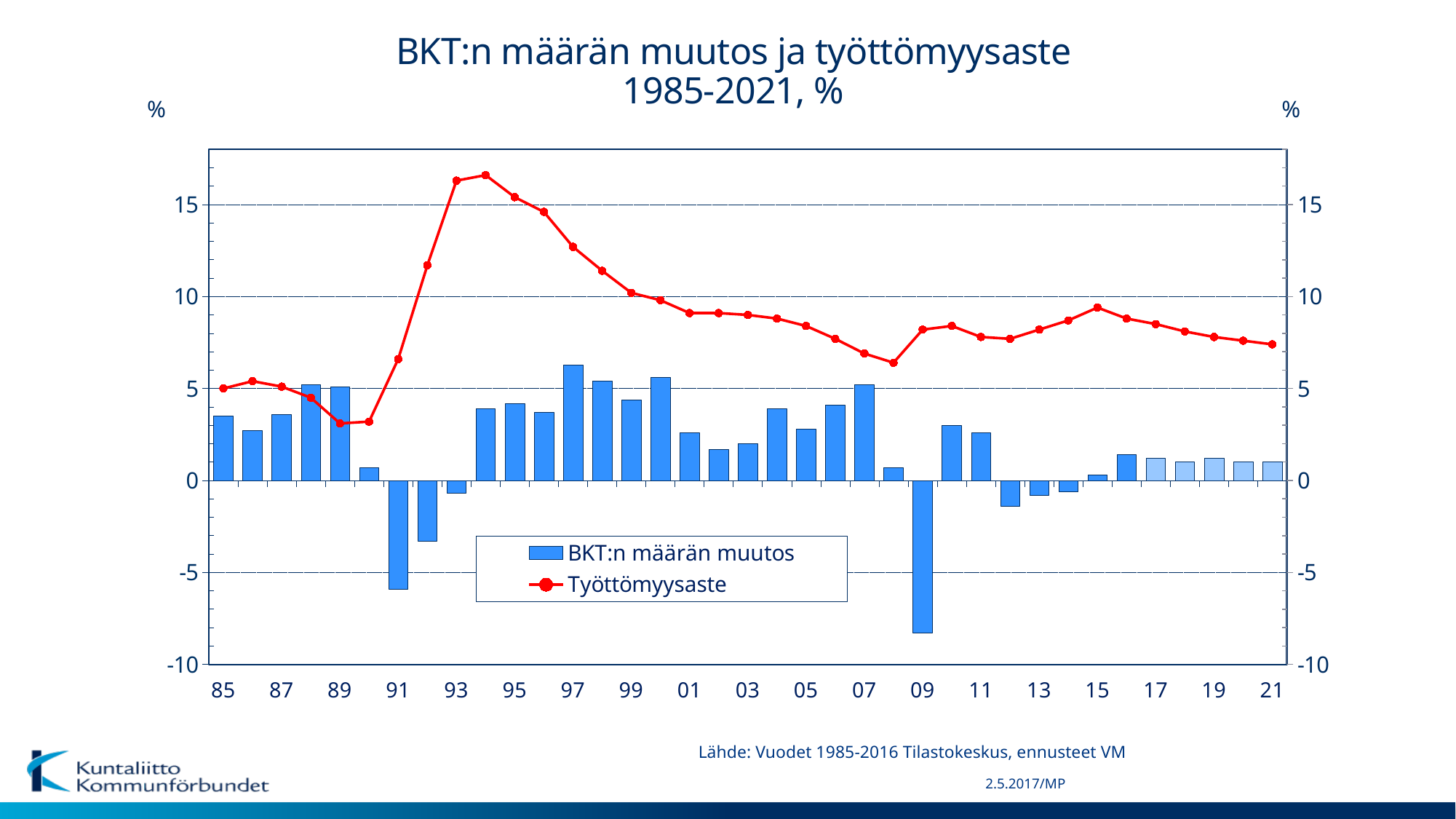
Is the BKT:n määrän muutos value for 2009 greater or less than -5? less Is the Työttömyysaste value for 1994 greater or less than 15? greater What is the title of the chart? BKT:n määrän muutos ja työttömyysaste 1985-2021, % In which year is the BKT:n määrän muutos bar the lowest? 2009 How many series does the legend list? 2 Does the Työttömyysaste line rise or fall between 1994 and 2008? fall Which series is drawn as a red line with markers? Työttömyysaste How many years are plotted on the x axis? 37 Which year has the higher Työttömyysaste, 1994 or 2015? 1994 What kind of chart is shown on the slide? A combination chart with bars and a line Is the BKT:n määrän muutos value for 1997 greater or less than 5? greater